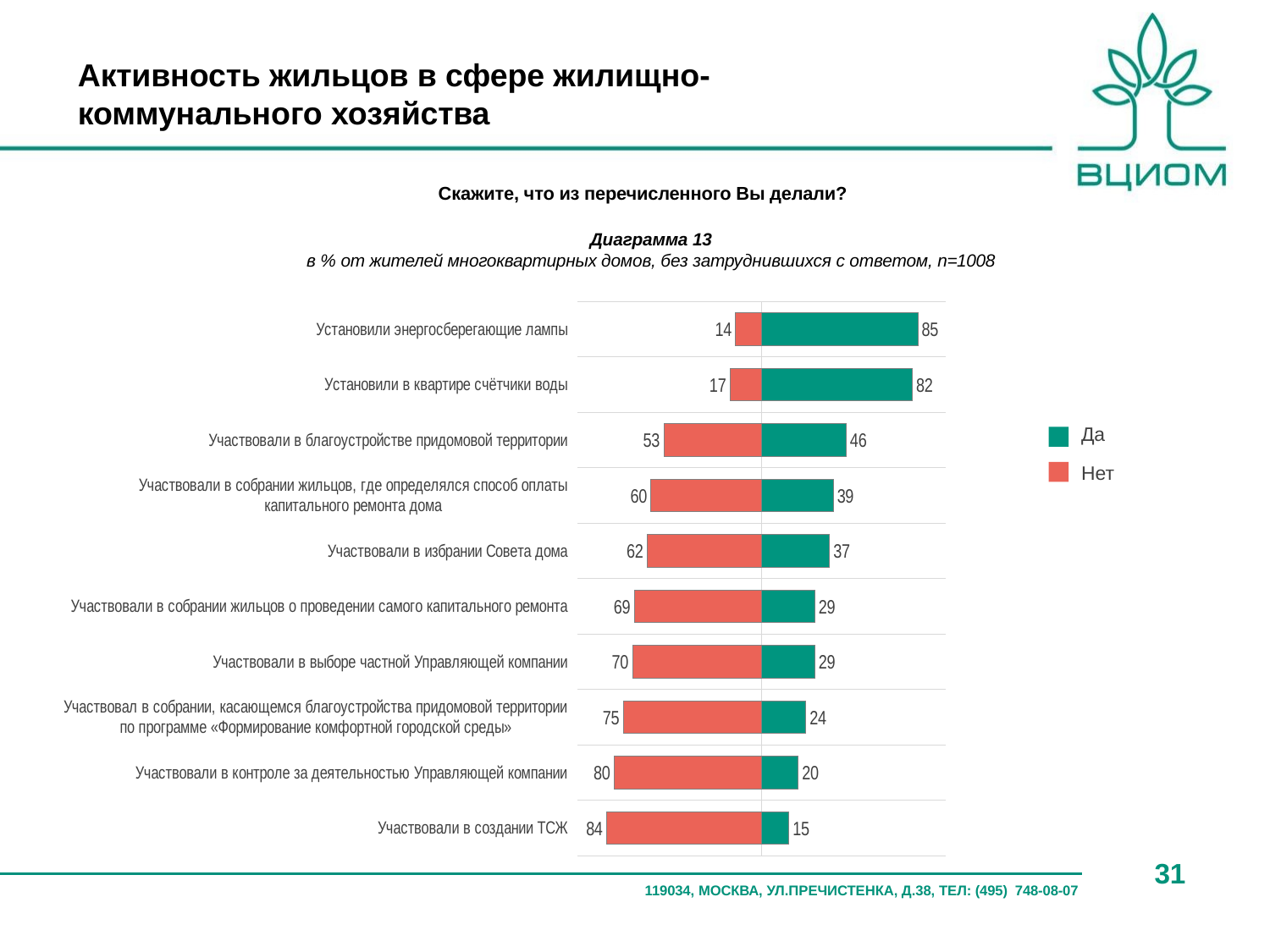
What is the "Да" value for "Участвовали в избрании Совета дома"? 37 What is the "Нет" value for "Участвовали в создании ТСЖ"? 84 Which category has the lowest "Да" value? Участвовали в создании ТСЖ What is the difference between the "Нет" and "Да" values for "Участвовали в контроле за деятельностью Управляющей компании"? 60 What is the difference between the "Да" values for "Установили в квартире счётчики воды" and "Участвовали в выборе частной Управляющей компании"? 53 What is the "Да" value for "Установили энергосберегающие лампы"? 85 Which is larger for "Участвовали в благоустройстве придомовой территории": the "Да" value or the "Нет" value? Нет Which colour represents the "Да" series in the legend? Green How many series does the legend list? 2 Which category has the highest "Да" value? Установили энергосберегающие лампы What type of chart is shown on the slide? Bar chart How many categories are shown in the chart? 10